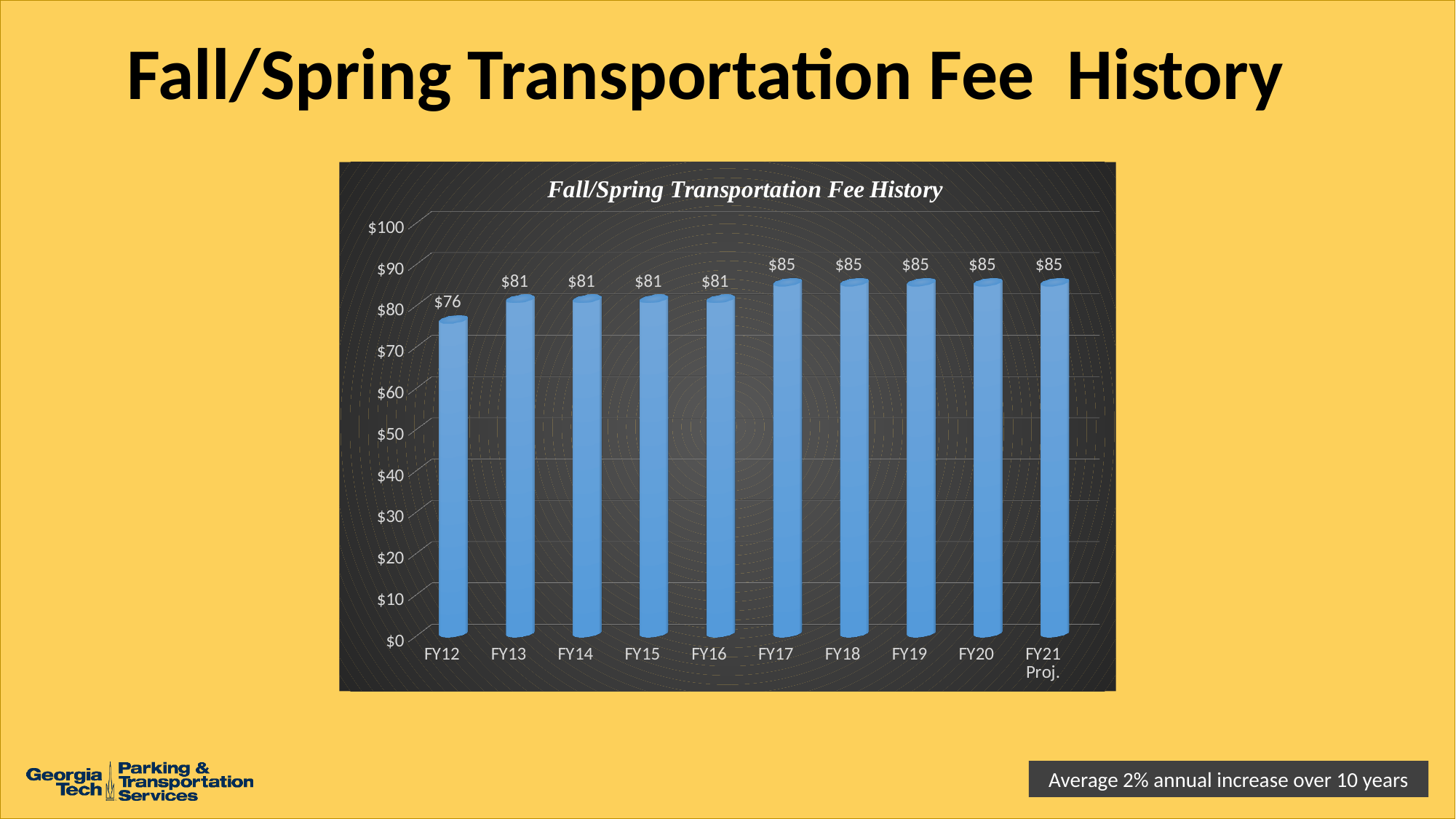
How many fiscal years are shown on the x axis? 10 What is the difference between the fee in FY17 and the fee in FY12? $9 Which fiscal year has the lowest fee? FY12 What is the fee value for FY15? $81 What is the projected fee value for FY21 Proj.? $85 Is the value for FY19 greater or less than $80? greater What is the fee value for FY12? $76 What is the difference between the fee in FY13 and the fee in FY12? $5 What kind of chart is shown on the slide? bar chart Do the fee values rise or fall from FY12 to FY21 Proj.? rise Which is larger, the fee for FY16 or the fee for FY17? FY17 Is the value for FY12 greater or less than $80? less